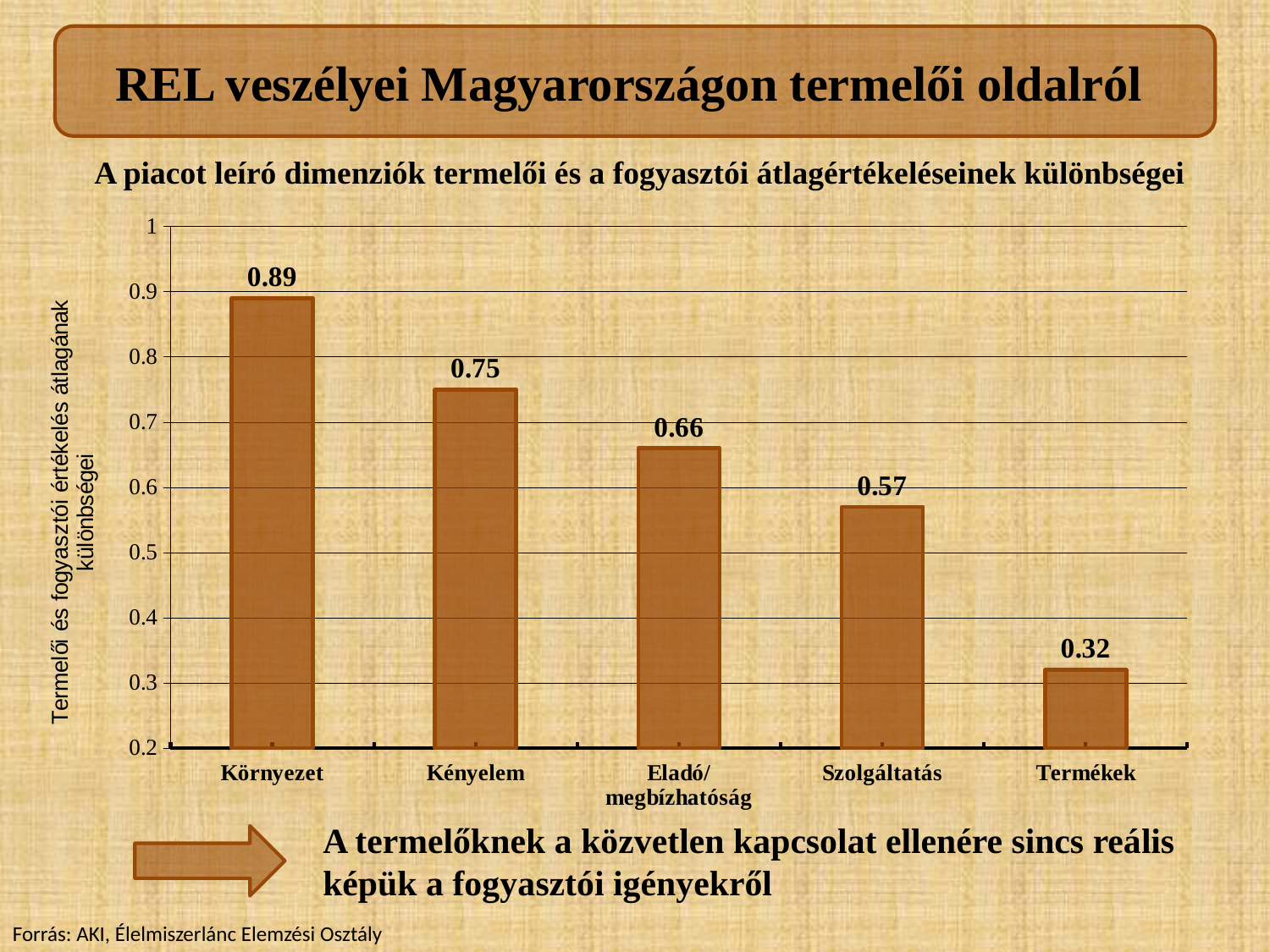
What kind of chart is shown on the slide? bar chart What is the difference between the values for Eladó/megbízhatóság and Termékek? 0.34 What is the value for Termékek? 0.32 Which category has the highest value? Környezet Is the value for Eladó/megbízhatóság greater or less than 0.7? less Do the values rise or fall from left to right along the x axis? fall What is the value for Környezet? 0.89 What is the difference between the values for Környezet and Kényelem? 0.14 How many categories are shown on the x axis? 5 Which category has the lowest value? Termékek What is the value for Szolgáltatás? 0.57 Which is larger, the value for Kényelem or the value for Szolgáltatás? Kényelem